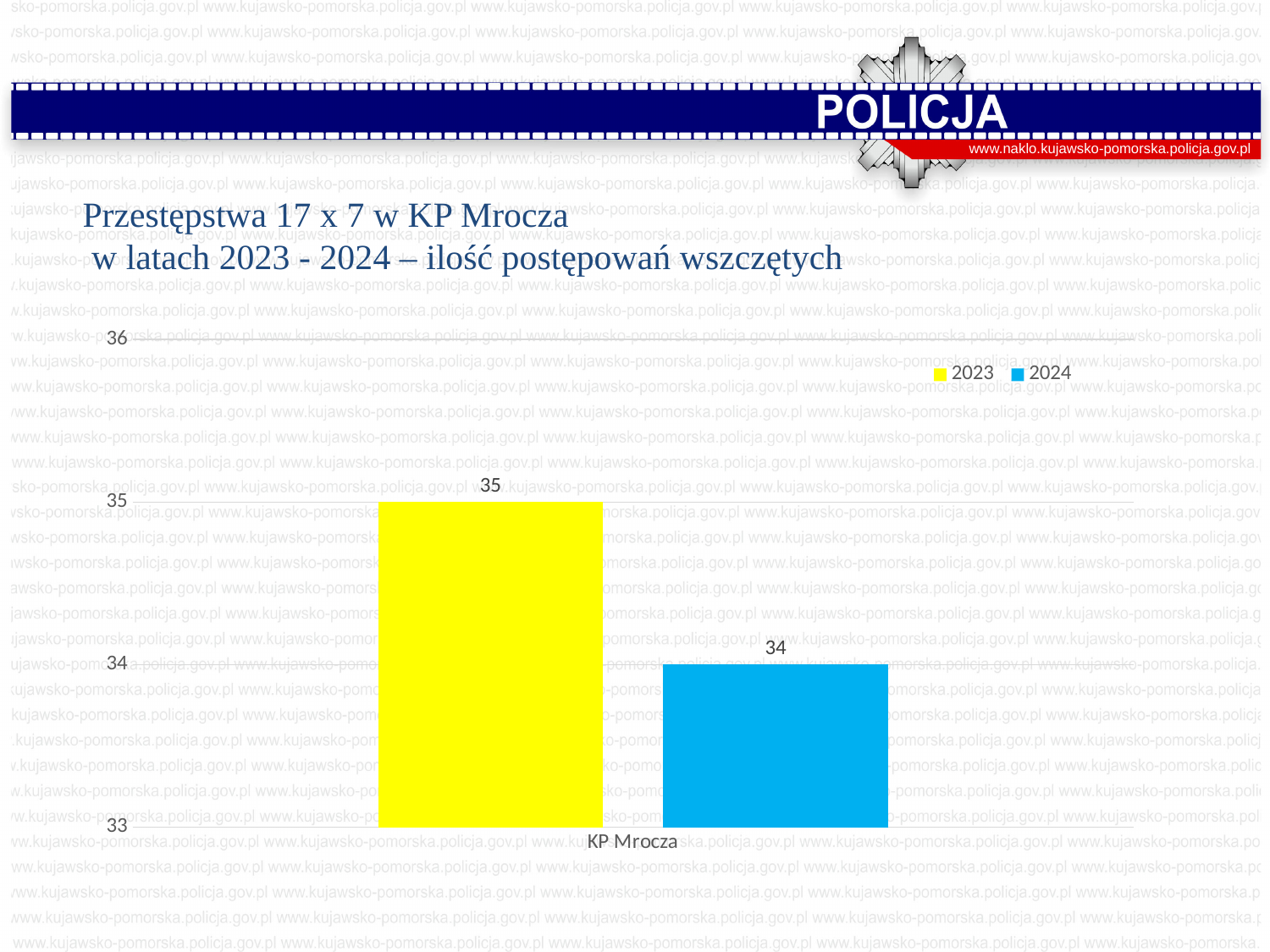
Is the value for 2023 greater or less than 34? greater Which series has the higher value, 2023 or 2024? 2023 What is the category label shown on the x axis? KP Mrocza Which colour represents the 2024 series in the chart? blue What is the difference between the 2023 value and the 2024 value? 1 What is the value for 2023 in the chart? 35 What kind of chart is shown on the slide? bar chart Which year has the lowest value in the chart? 2024 Is the value for 2024 greater or less than 35? less Which year has the highest value in the chart? 2023 How many series does the legend list? 2 What is the value for 2024 in the chart? 34